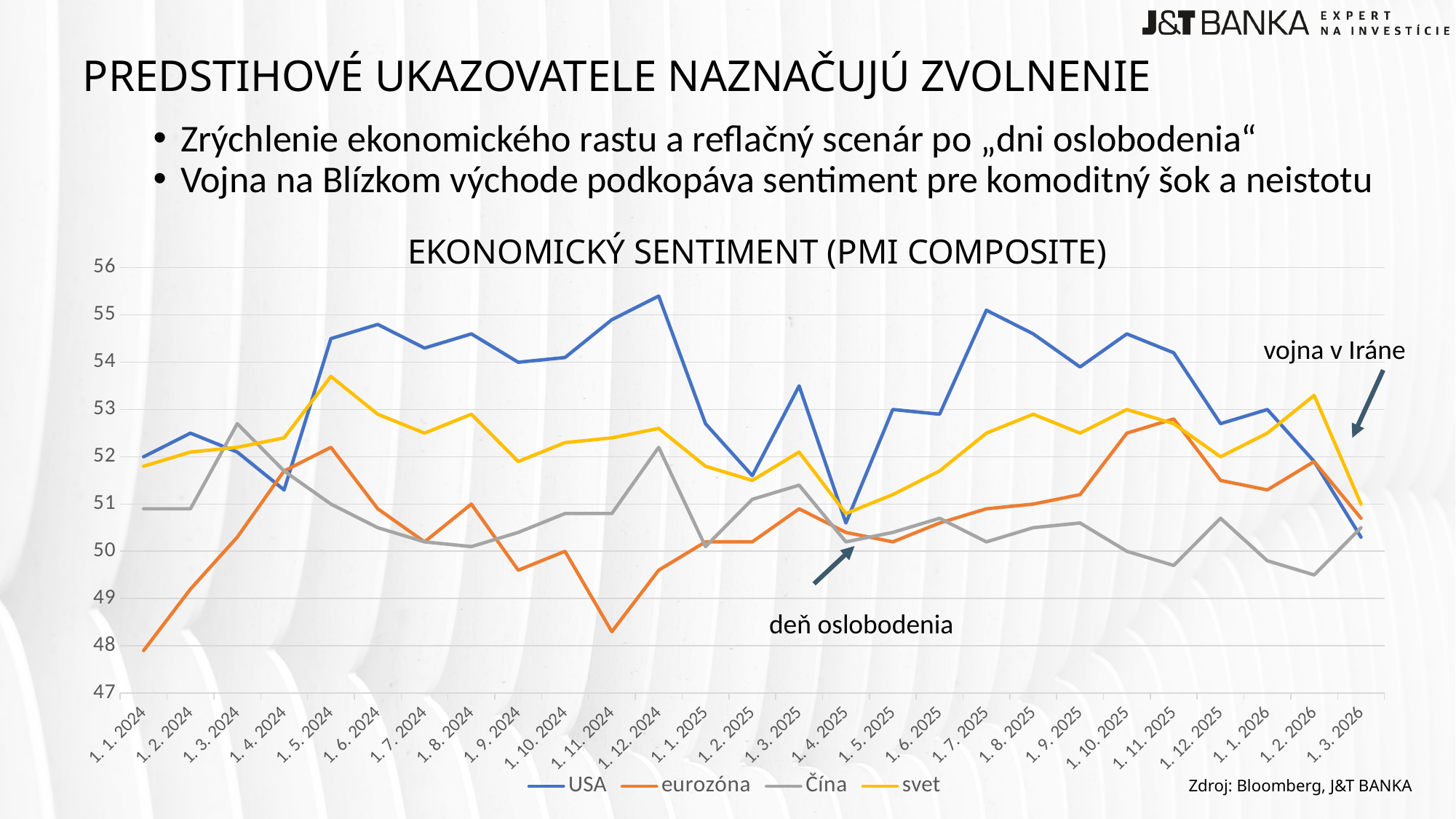
Is the value for svet at 1. 5. 2024 greater or less than 53? greater How many dates are labelled on the x axis of the chart? 27 Is the value for Čína at 1. 2. 2026 greater or less than 50? less What is the title of the chart? EKONOMICKÝ SENTIMENT (PMI COMPOSITE) Which series has the highest value at 1. 12. 2024? USA Is the value for USA at 1. 12. 2024 greater or less than 55? greater At 1. 1. 2024, which is larger: the value for USA or the value for eurozóna? USA How many series does the legend of the chart list? 4 What kind of chart is shown on the slide? line chart Which series has the lowest value at 1. 11. 2024? eurozóna Which series is shown in orange in the chart? eurozóna